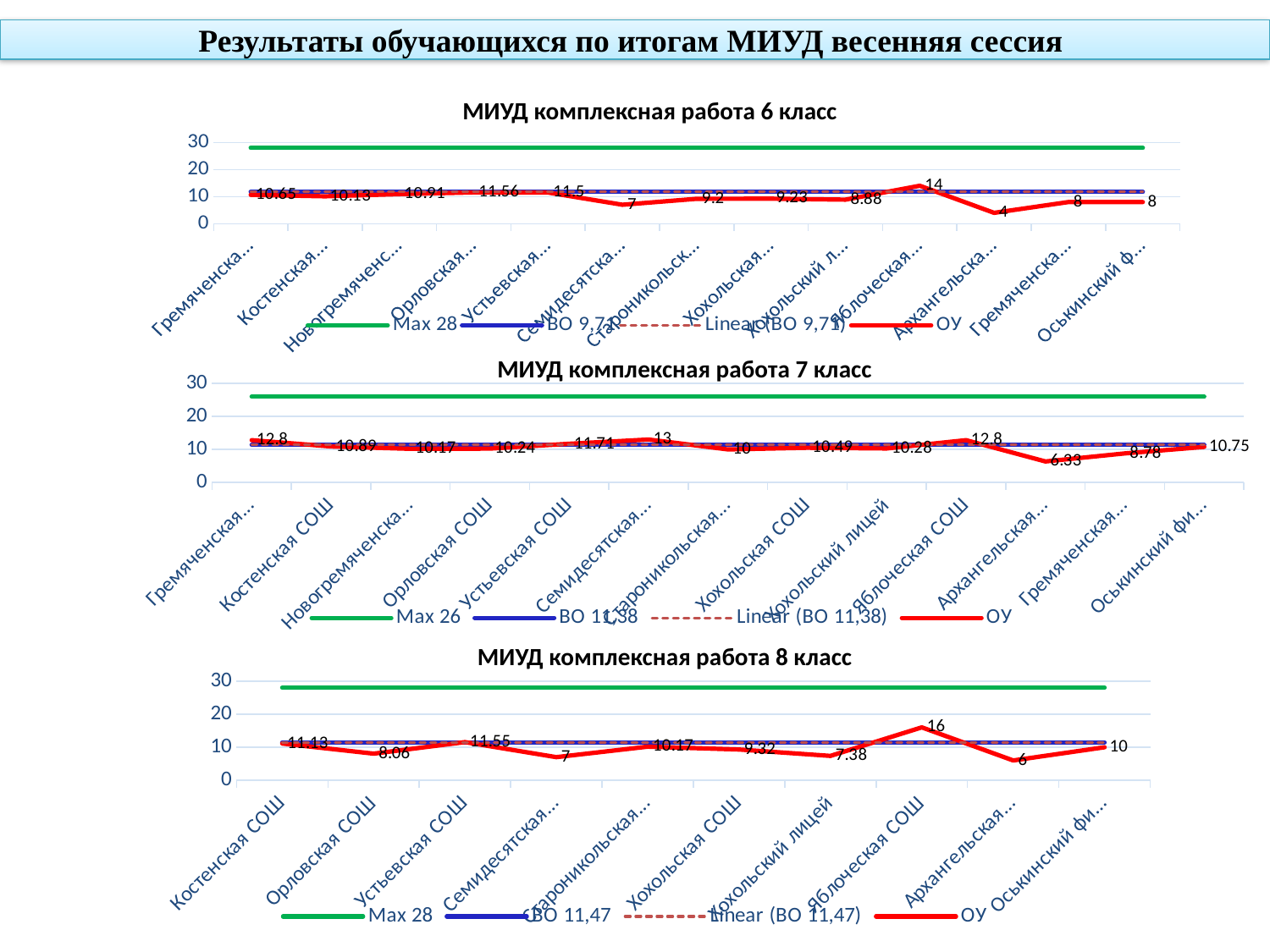
In the chart titled 'МИУД комплексная работа 8 класс', what is the ОУ value for Яблоческая СОШ? 16 In the chart titled 'МИУД комплексная работа 6 класс', how many series does the legend list? 4 In the chart titled 'МИУД комплексная работа 8 класс', what is the ОУ value for Хохольский лицей? 7.38 In the chart titled 'МИУД комплексная работа 7 класс', what is the ОУ value for Хохольский лицей? 10.28 What is the title of the top chart on the slide? МИУД комплексная работа 6 класс What type of chart is 'МИУД комплексная работа 7 класс'? Line chart In the chart titled 'МИУД комплексная работа 8 класс', what is the difference between the ОУ values for Яблоческая СОШ and Хохольский лицей? 8.62 In the chart titled 'МИУД комплексная работа 8 класс', which school has the highest ОУ value? Яблоческая СОШ In the chart titled 'МИУД комплексная работа 7 класс', what is the ОУ value for Костенская СОШ? 10.89 In the chart titled 'МИУД комплексная работа 7 класс', which has the larger ОУ value: Костенская СОШ or Орловская СОШ? Костенская СОШ In the chart titled 'МИУД комплексная работа 8 класс', how many schools are shown on the x axis? 10 In the chart titled 'МИУД комплексная работа 6 класс', is the Max 28 line greater or less than 20? greater